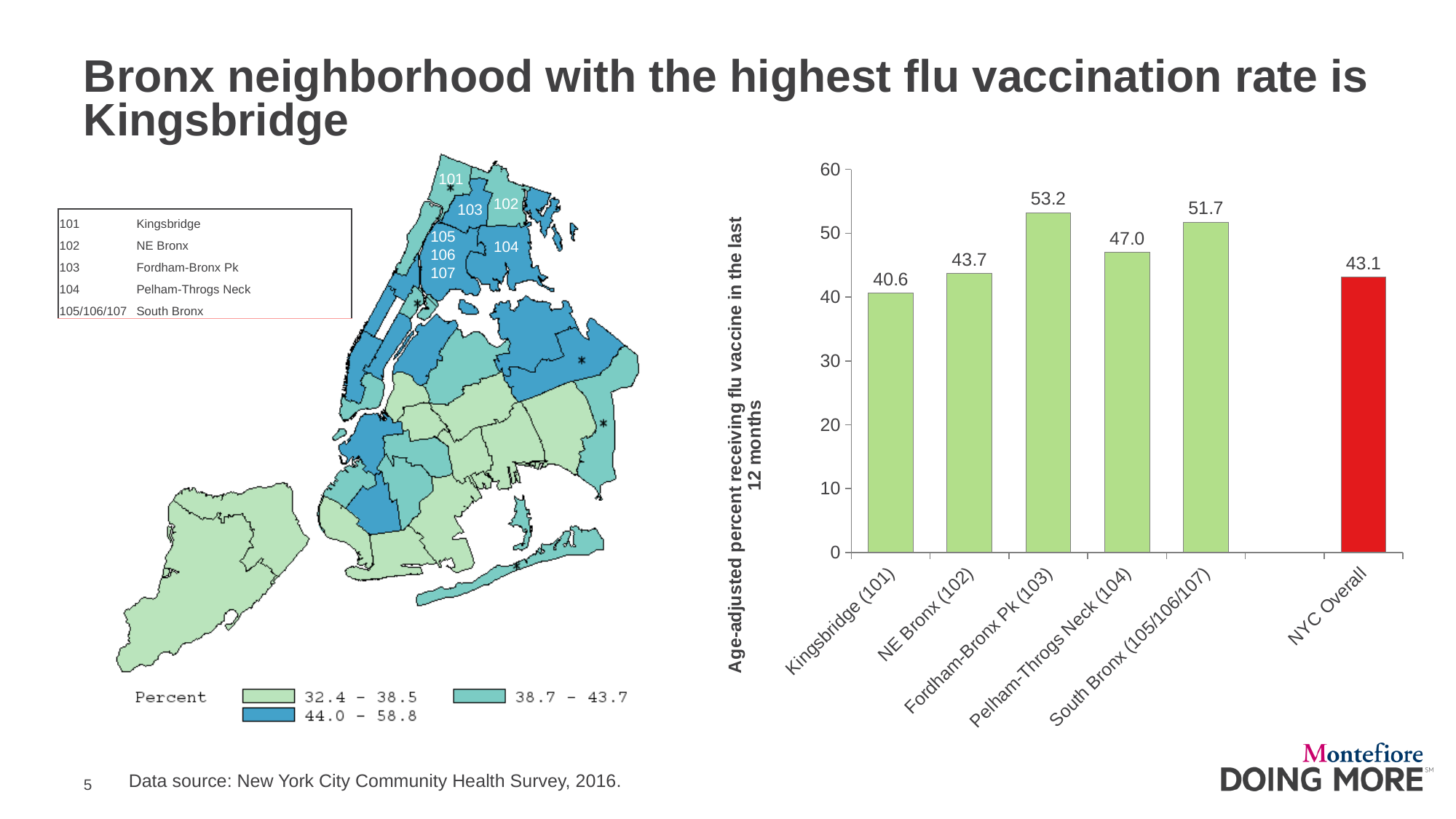
In the bar chart, which bar is coloured red? NYC Overall In the bar chart, what is the value for NYC Overall? 43.1 In the bar chart, what is the difference between Fordham-Bronx Pk (103) and Kingsbridge (101)? 12.6 In the bar chart, which category has the lowest value? Kingsbridge (101) In the bar chart, which is larger, the value for NE Bronx (102) or the value for Pelham-Throgs Neck (104)? Pelham-Throgs Neck (104) How many bars are shown in the bar chart? 6 In the bar chart, what is the value for Kingsbridge (101)? 40.6 What kind of chart is shown on the right side of the slide? bar chart In the bar chart, is the value for South Bronx (105/106/107) greater or less than 50? greater In the bar chart, which category has the highest value? Fordham-Bronx Pk (103) In the bar chart, what is the value for South Bronx (105/106/107)? 51.7 In the bar chart, what is the difference between Pelham-Throgs Neck (104) and NYC Overall? 3.9